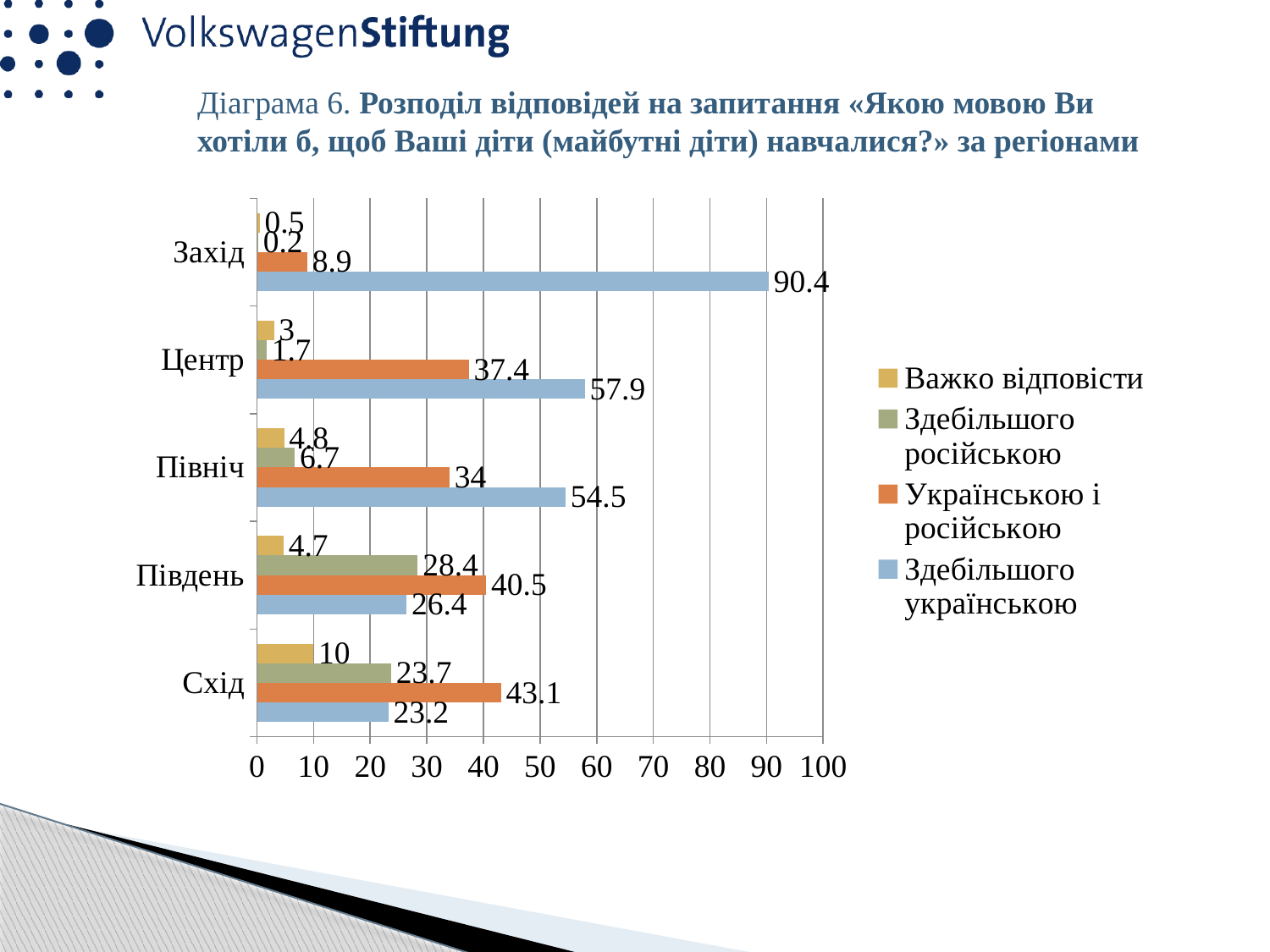
How many regions (categories) are shown on the chart? 5 Which region has the highest value for «Здебільшого українською»? Захід What type of chart is shown on the slide? bar chart What is the value for «Здебільшого російською» in Південь? 28.4 What is the value for «Українською і російською» in Центр? 37.4 What is the value for «Важко відповісти» in Схід? 10 What is the value for «Здебільшого українською» in Захід? 90.4 Which series is shown in blue in the legend? Здебільшого українською Which region has the lowest value for «Здебільшого російською»? Захід In Схід, which is larger: «Українською і російською» or «Здебільшого українською»? Українською і російською What is the difference between «Здебільшого українською» in Центр and in Північ? 3.4 How many series does the legend list? 4